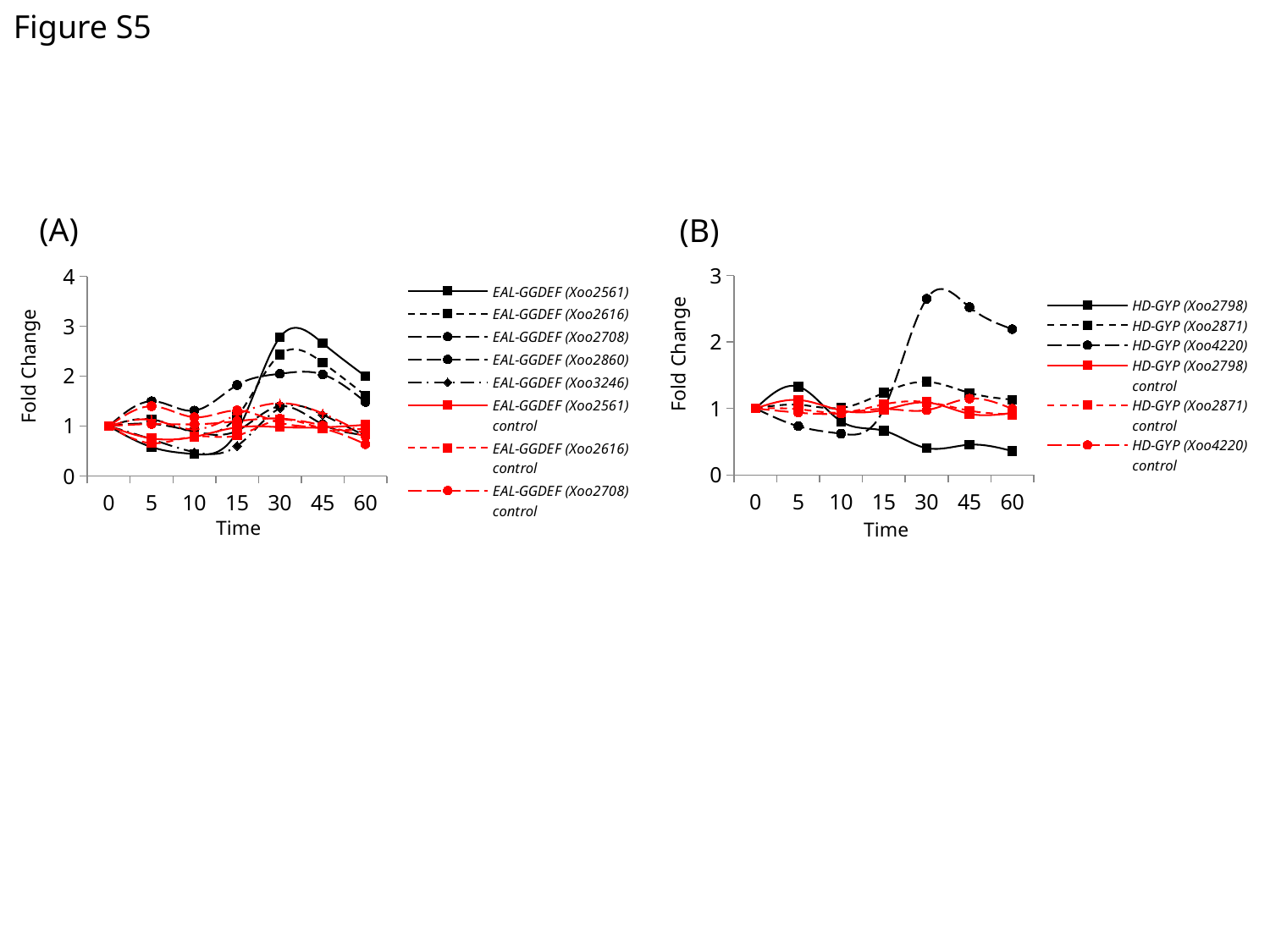
In chart (A), is the value for EAL-GGDEF (Xoo2561) at time 30 greater or less than 2? greater What is the y-axis title of chart (B)? Fold Change What kind of chart is chart (A)? line chart In chart (A), which series has the highest value at time 30? EAL-GGDEF (Xoo2561) How many time points are shown on the x axis of chart (B)? 7 In chart (B), is the value for HD-GYP (Xoo4220) at time 30 greater or less than 2? greater In chart (B), at time 60, which is larger: HD-GYP (Xoo4220) or HD-GYP (Xoo2798)? HD-GYP (Xoo4220) How many series does the legend of chart (A) list? 8 In chart (B), which series has the highest value at time 30? HD-GYP (Xoo4220) In chart (A), what is the fold change value of every series at time 0? 1 How many series does the legend of chart (B) list? 6 In chart (B), is the value for HD-GYP (Xoo2798) at time 60 greater or less than 1? less